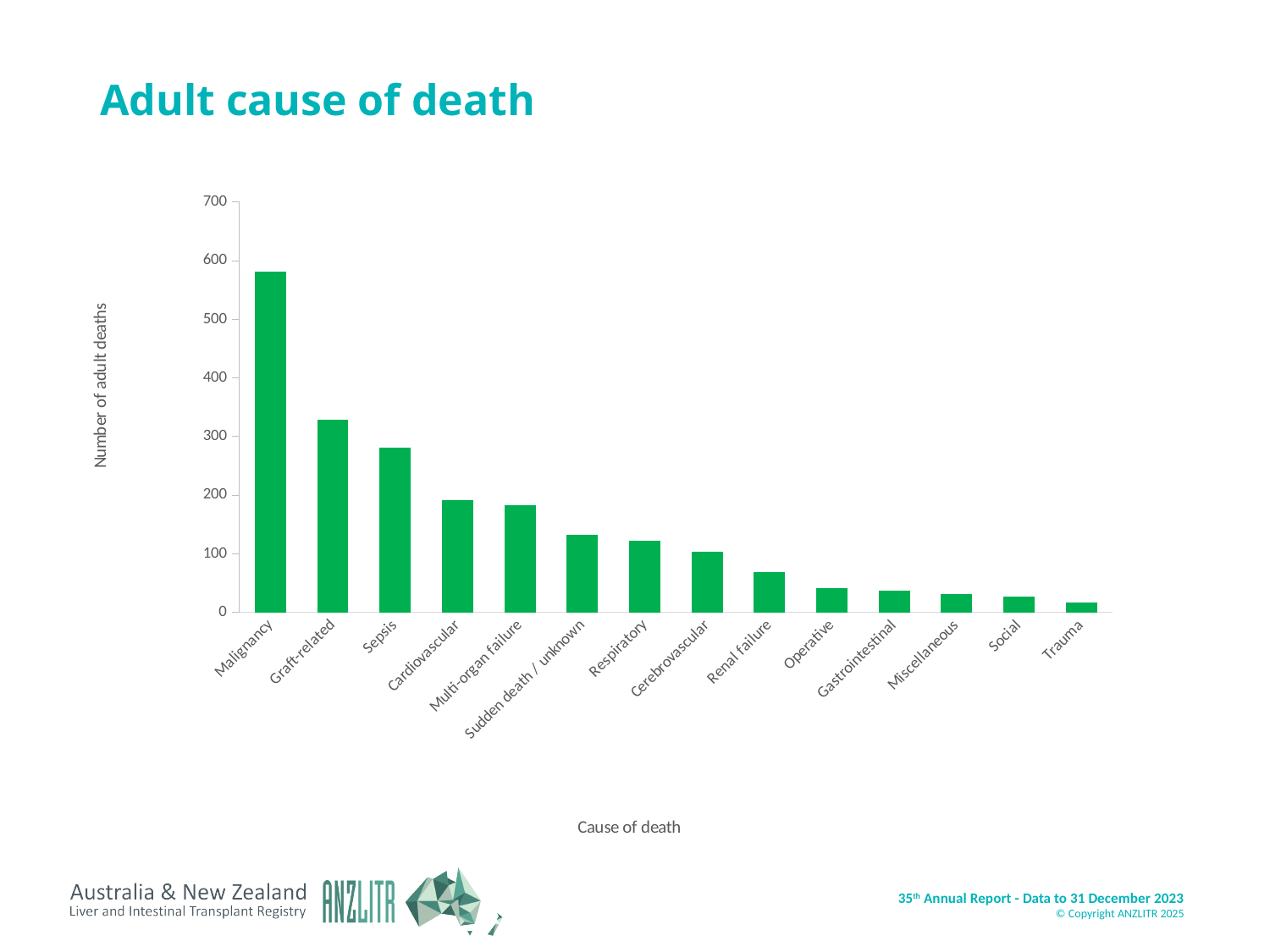
Which has more adult deaths, Renal failure or Operative? Renal failure Is the value for Malignancy greater or less than 500? greater Is the value for Graft-related greater or less than 300? greater Do the bar values rise or fall moving from left to right along the x axis? Fall What is the label of the vertical axis? Number of adult deaths Which cause of death has the highest number of adult deaths? Malignancy Is the value for Sepsis greater or less than 300? less Which has more adult deaths, Sepsis or Cardiovascular? Sepsis How many causes of death are plotted on the chart? 14 Which cause of death has the lowest number of adult deaths? Trauma What kind of chart is shown on the slide? Bar chart